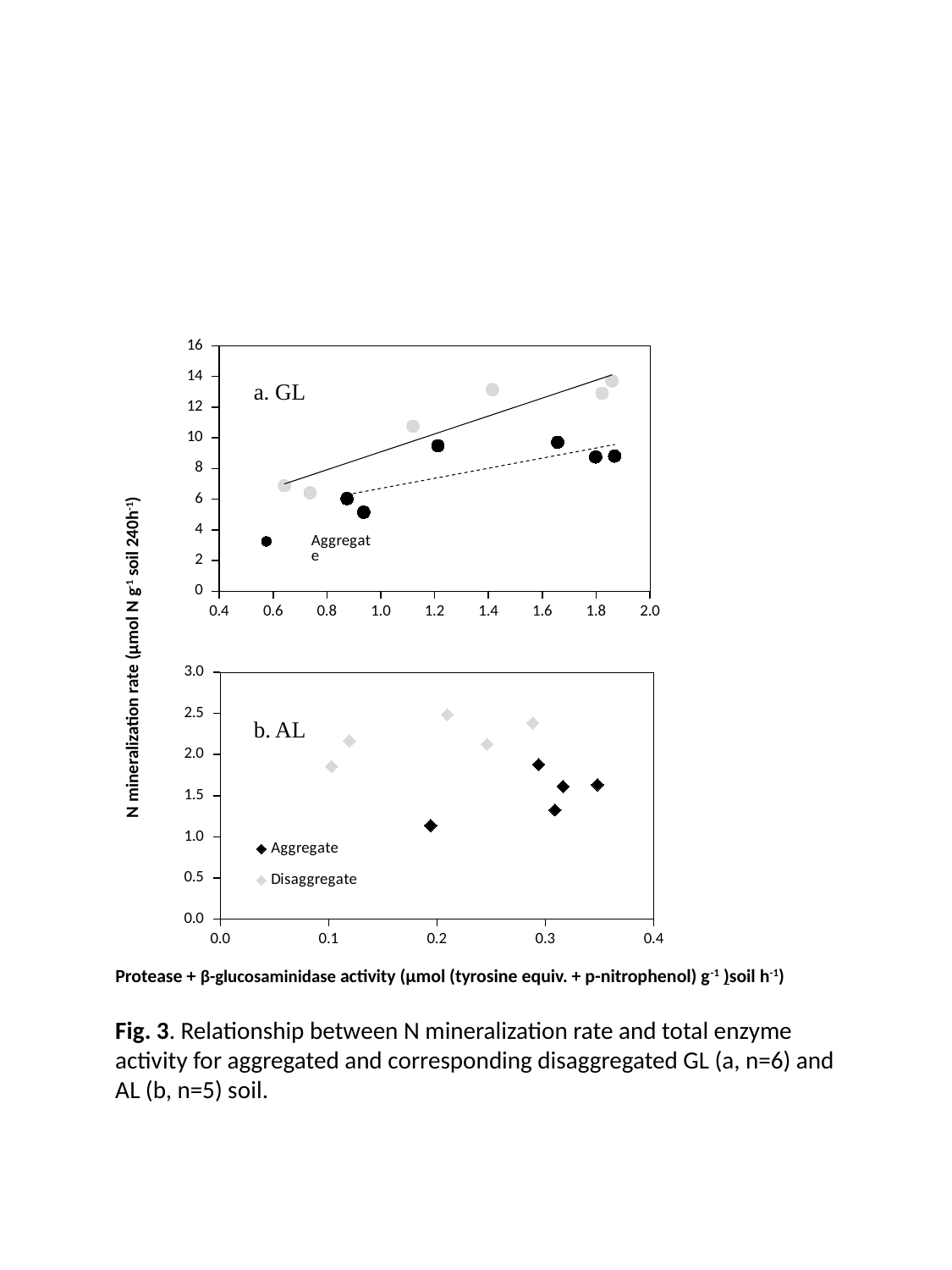
In chart a (GL), is the lowest Aggregate (black) point greater or less than 4? less In chart b (AL), is the highest Disaggregate (grey) point greater or less than 2.0? greater What are the two series named in the legend of chart b (AL)? Aggregate and Disaggregate What kind of chart is chart a (GL)? Scatter chart What is the maximum value shown on the y axis of chart b (AL)? 3.0 In chart b (AL), how many Aggregate (black diamond) points are plotted? 5 In chart a (GL), do the N mineralization rate values generally rise or fall as enzyme activity increases along the x axis? Rise How many series does the legend in chart b (AL) list? 2 What kind of chart is chart b (AL)? Scatter chart In chart b (AL), is the lowest Aggregate (black) point greater or less than 1.5? less In chart a (GL), which series has the higher fitted line, Aggregate or Disaggregate? Disaggregate